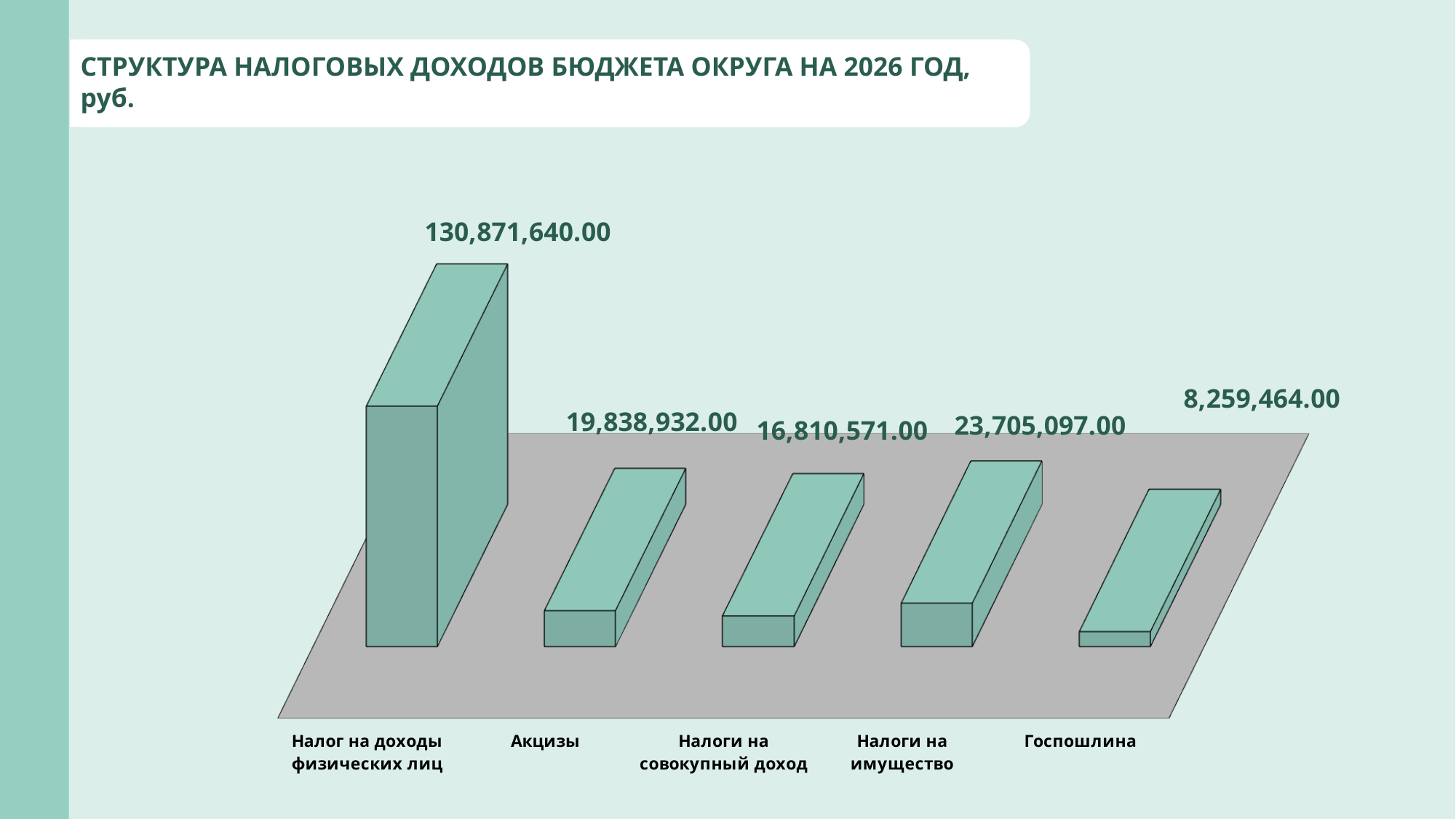
What is the difference between the values for Налоги на имущество and Госпошлина? 15,445,633.00 What kind of chart is shown on the slide? Bar chart What is the value for Акцизы? 19,838,932.00 What is the difference between the values for Акцизы and Налоги на совокупный доход? 3,028,361.00 Which category has the lowest value? Госпошлина What is the value for Налог на доходы физических лиц? 130,871,640.00 What is the value for Налоги на имущество? 23,705,097.00 Which is larger, the value for Налоги на имущество or the value for Акцизы? Налоги на имущество What is the value for Госпошлина? 8,259,464.00 How many categories are shown in the chart? 5 What is the value for Налоги на совокупный доход? 16,810,571.00 Which category has the highest value? Налог на доходы физических лиц